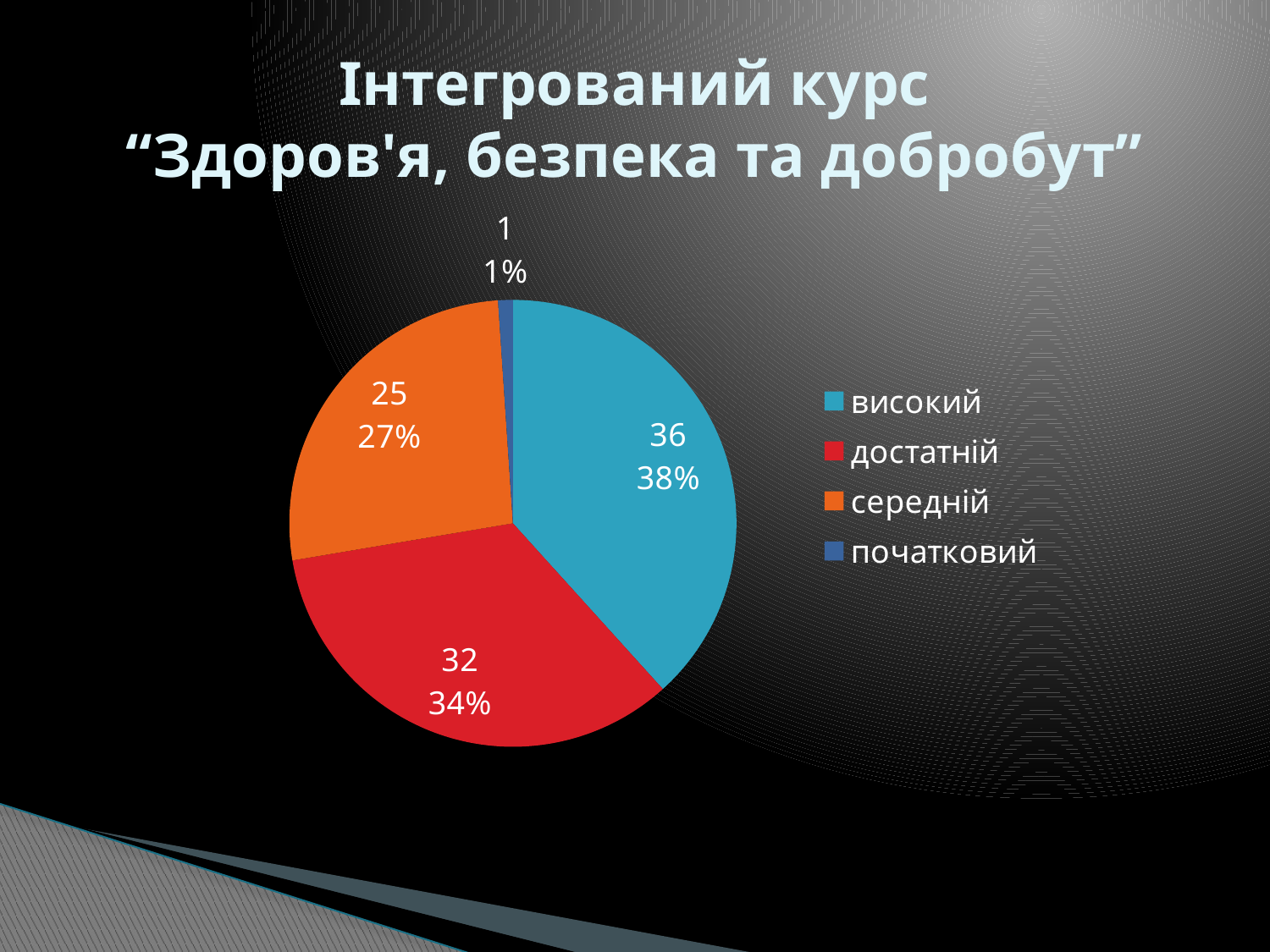
What is the value for високий? 36 What is the value for початковий? 1 Which category has the largest slice? високий What is the value for достатній? 32 What share of the pie does достатній take? 34% What share of the pie does середній take? 27% How many categories does the legend list? 4 What is the difference between the values for високий and середній? 11 Which is larger, the value for достатній or the value for середній? достатній What is the value for середній? 25 Which category has the smallest slice? початковий What kind of chart is shown on the slide? pie chart